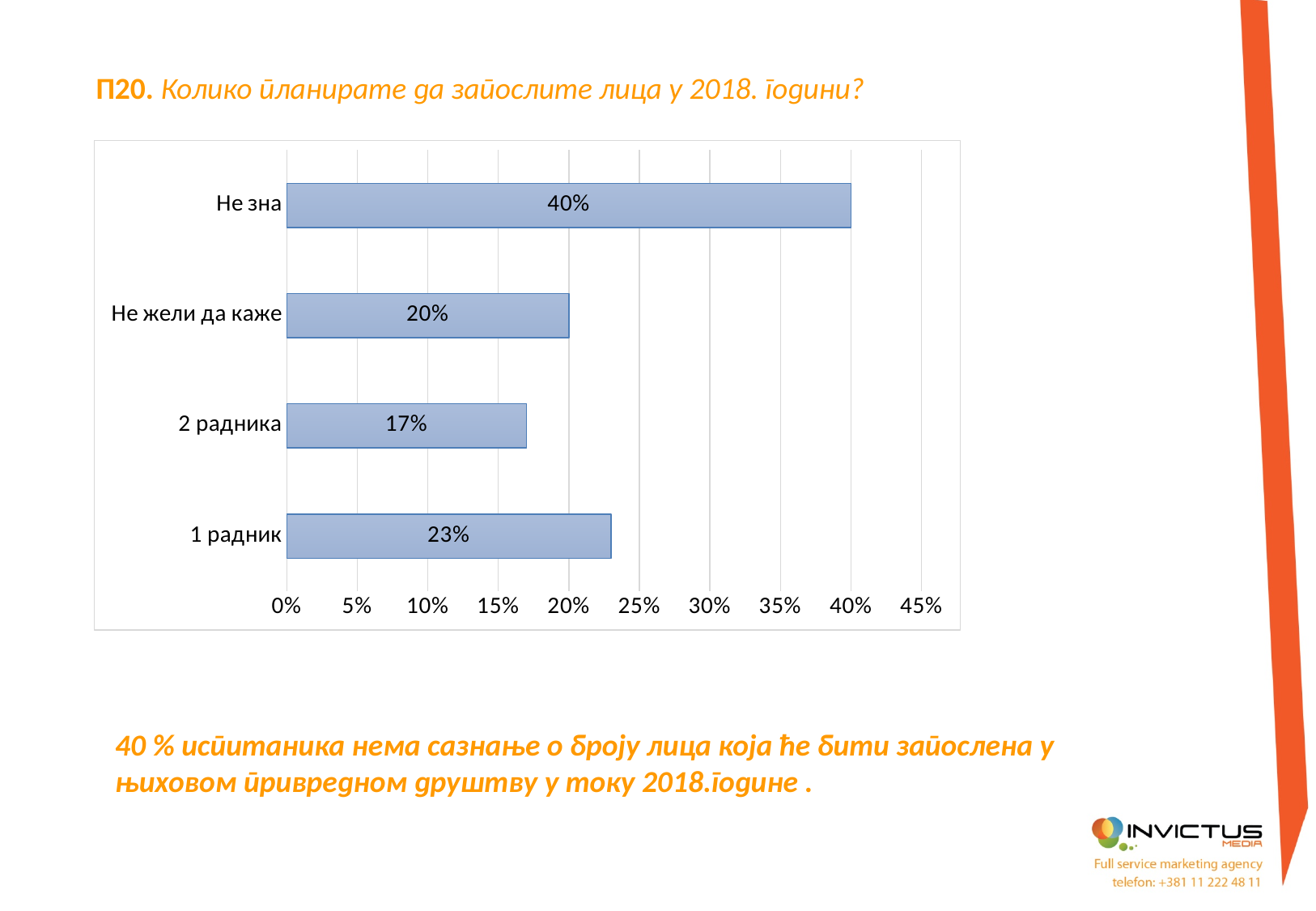
What is the difference between the values for "Не зна" and "1 радник"? 17% What is the value for "1 радник"? 23% Which category has the lowest value? 2 радника How many categories are shown in the chart? 4 What is the value for "Не жели да каже"? 20% Which is larger, the value for "1 радник" or the value for "Не жели да каже"? 1 радник What is the highest value shown on the x axis? 45% Which category has the highest value? Не зна What is the difference between the values for "1 радник" and "2 радника"? 6% What is the value for "Не зна"? 40% What kind of chart is shown on the slide? Bar chart What is the value for "2 радника"? 17%